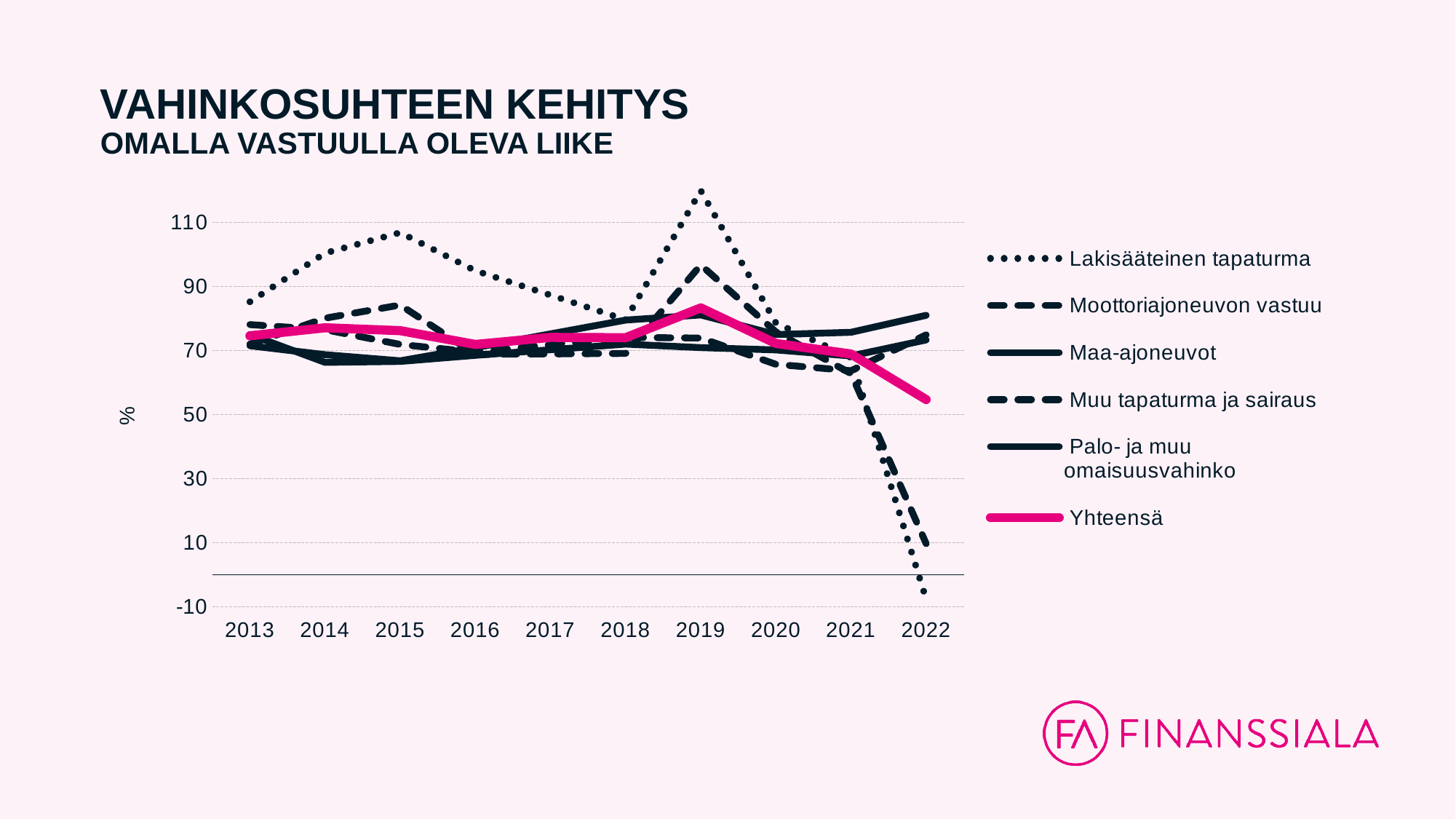
In which year does the Lakisääteinen tapaturma line reach its highest value? 2019 How many years are shown on the x axis? 10 What kind of chart is shown on the slide? line chart Is the value for Yhteensä in 2022 greater or less than 70? less Is the value for Lakisääteinen tapaturma in 2022 greater or less than 10? less Is the value for Moottoriajoneuvon vastuu in 2019 greater or less than 90? greater Which series is drawn with the pink line? Yhteensä Does the Yhteensä line rise or fall from 2019 to 2022? fall Which series has the lowest value in 2022? Lakisääteinen tapaturma How many series does the legend list? 6 In which year does the Yhteensä line reach its lowest value? 2022